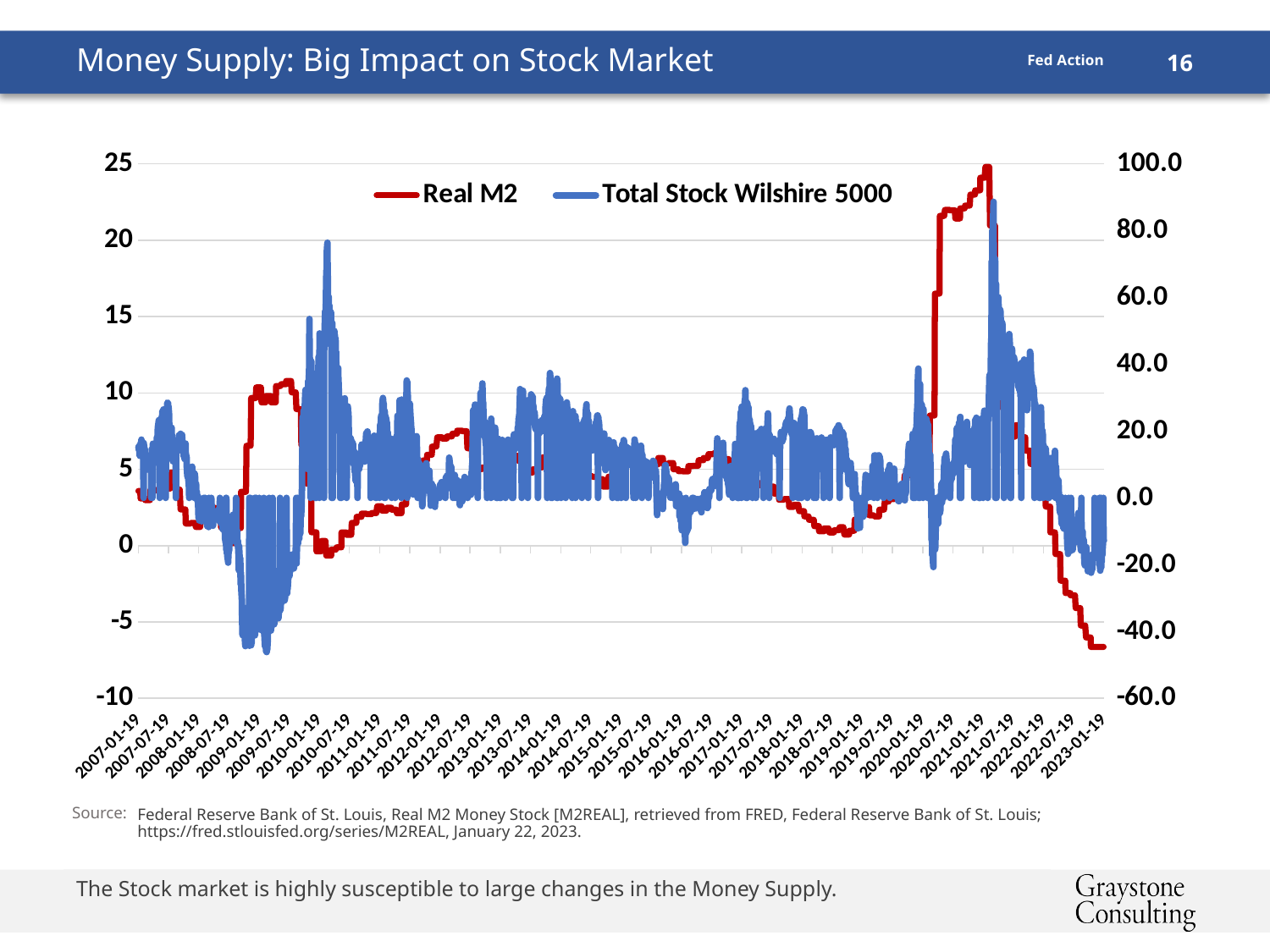
Does the Real M2 series rise or fall between 2021-01-19 and 2023-01-19? Fall What kind of chart is shown on the slide? Line chart Is the lowest value of Total Stock Wilshire 5000 around early 2009 greater or less than -20.0 on the right axis? less What is the name of the series drawn in blue? Total Stock Wilshire 5000 Is the value of Real M2 around 2009-07-19 greater or less than 5 on the left axis? greater How many series does the chart's legend list? 2 Is the value of Real M2 at its peak around 2021-01-19 greater or less than 20 on the left axis? greater Does the Real M2 series rise or fall between 2019-07-19 and 2021-01-19? Rise What is the highest value shown on the right-hand axis of the chart? 100.0 Which series is drawn in red in the chart? Real M2